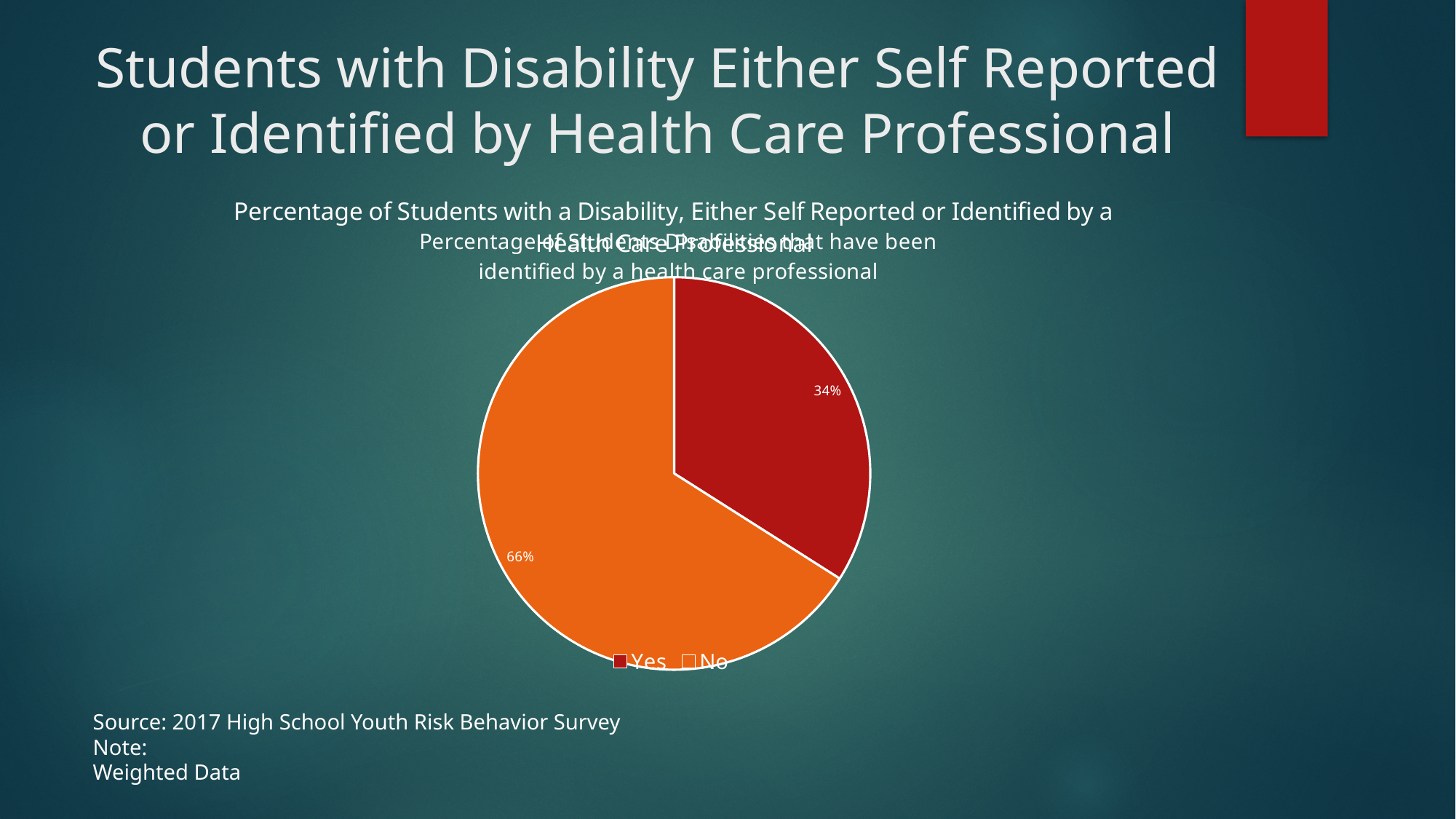
Which slice of the pie is the smallest? Yes What colour is the "No" slice in the pie chart? orange What percentage of the pie is the "Yes" slice? 34% What is the difference in percentage points between the "No" slice and the "Yes" slice? 32 How many entries does the legend list? 2 What colour is the "Yes" slice in the pie chart? dark red What percentage of the pie is the "No" slice? 66% Which is larger, the "Yes" slice or the "No" slice? No What kind of chart is shown on the slide? pie chart What share of the pie does the "No" slice represent? 66% How many slices does the pie chart have? 2 Which slice of the pie is the largest? No